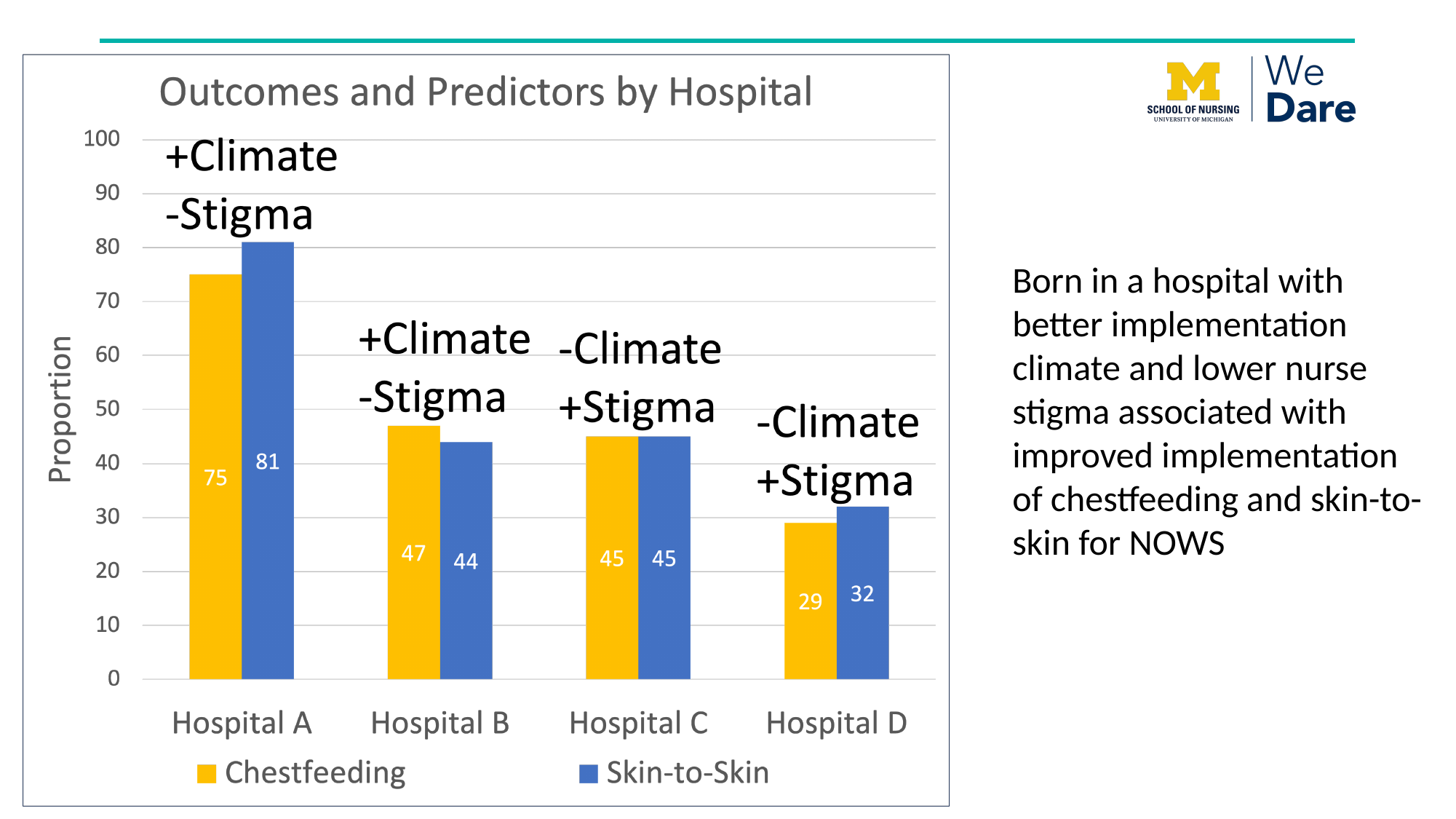
How many series does the legend list? 2 What kind of chart is shown? bar chart How many hospitals are shown on the x axis? 4 What is the Skin-to-Skin value for Hospital D? 32 What is the difference between the Skin-to-Skin and Chestfeeding values for Hospital A? 6 What is the Skin-to-Skin value for Hospital B? 44 Which is larger for Hospital B, the Chestfeeding value or the Skin-to-Skin value? Chestfeeding Which hospital has the lowest Chestfeeding value? Hospital D What is the title of the chart? Outcomes and Predictors by Hospital Which hospital has the highest Skin-to-Skin value? Hospital A What is the Chestfeeding value for Hospital A? 75 Is the Chestfeeding value for Hospital C greater or less than 50? less